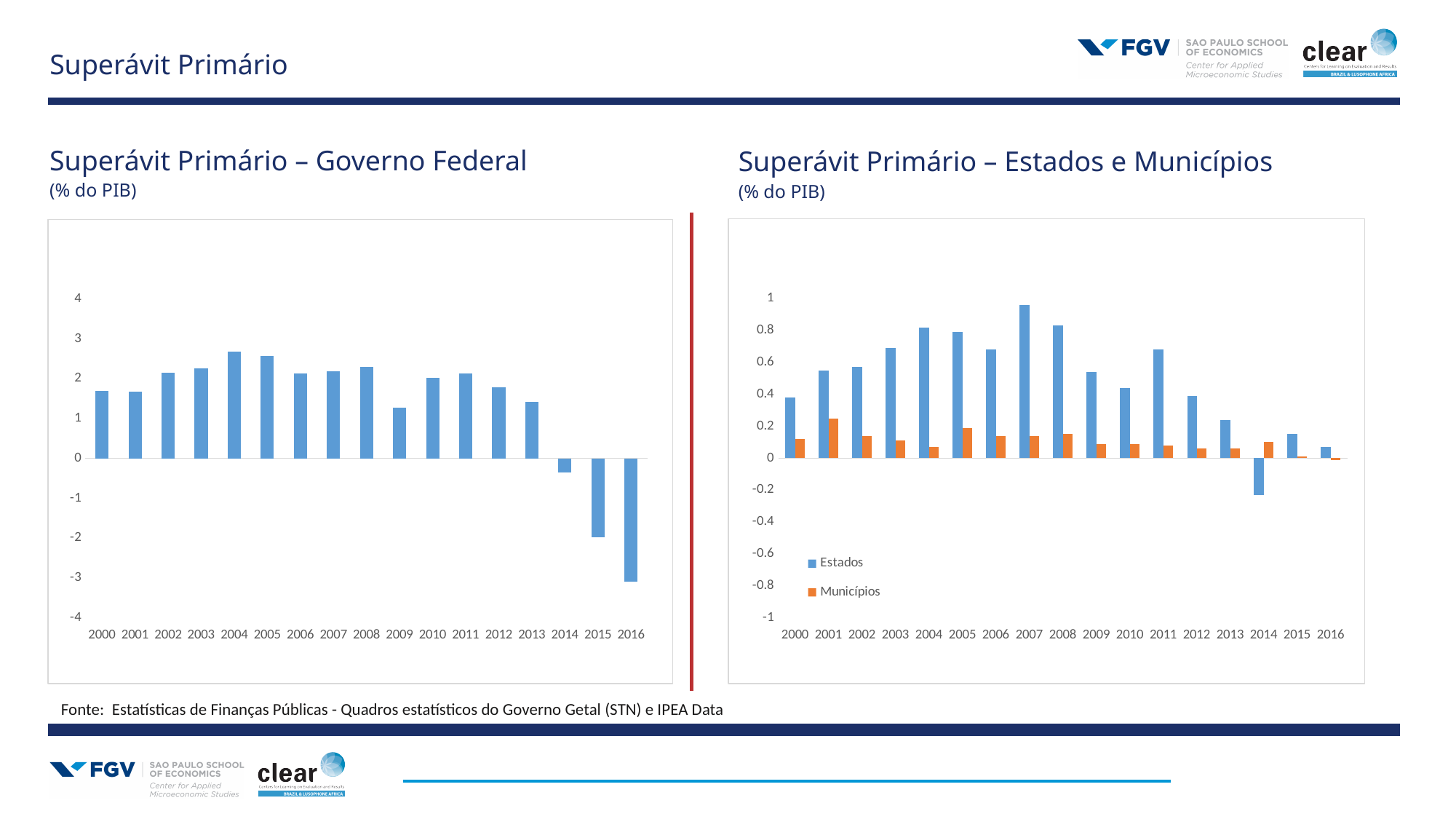
In the 'Superávit Primário – Estados e Municípios' chart, which year has the highest value for Estados? 2007 How many series does the legend of the 'Superávit Primário – Estados e Municípios' chart list? 2 In the 'Superávit Primário – Governo Federal' chart, which is larger, the value for 2004 or the value for 2009? 2004 In the 'Superávit Primário – Governo Federal' chart, which year has the lowest value? 2016 In the 'Superávit Primário – Estados e Municípios' chart, which series is larger in 2007, Estados or Municípios? Estados How many years are shown on the x axis of the 'Superávit Primário – Governo Federal' chart? 17 In the 'Superávit Primário – Governo Federal' chart, do the values rise or fall from 2013 to 2016? fall In the 'Superávit Primário – Governo Federal' chart, is the value for 2004 greater or less than 2? greater In the 'Superávit Primário – Governo Federal' chart, is the value for 2014 greater or less than 0? less In the 'Superávit Primário – Estados e Municípios' chart, is the Estados value for 2014 greater or less than 0? less In the 'Superávit Primário – Governo Federal' chart, which year has the highest value? 2004 What kind of chart is the 'Superávit Primário – Governo Federal' chart? Bar chart